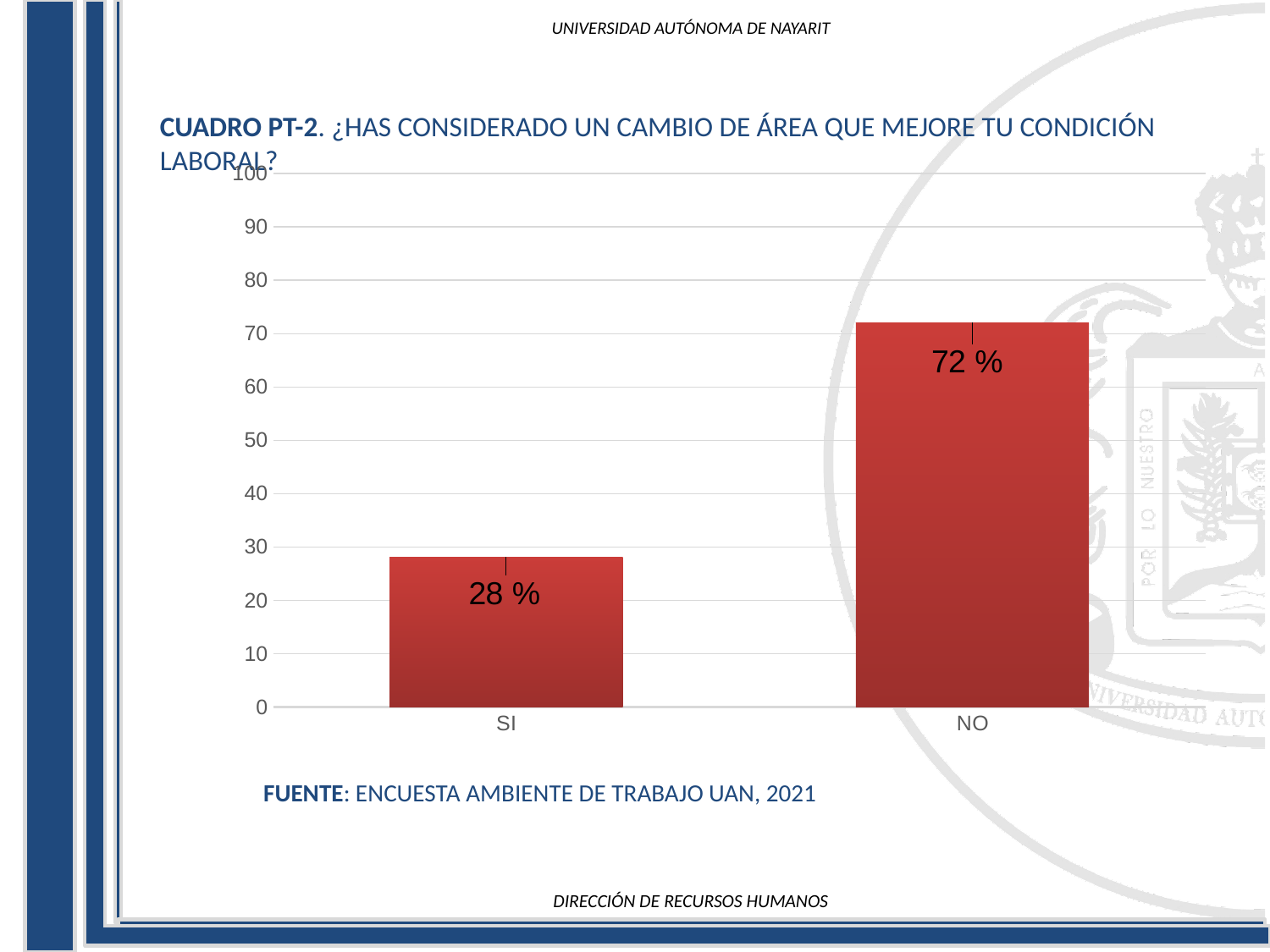
What kind of chart is shown on the slide? bar chart What is the difference between the values for NO and SI? 44 % Is the value for SI greater or less than 30? less What is the value for SI? 28 % Which category has the lowest value? SI Which category has the highest value? NO What is the value for NO? 72 % How many categories are shown on the x axis? 2 Is the value for NO greater or less than 70? greater What is the total of the two values shown in the chart? 100 % Which is larger, the value for SI or the value for NO? NO What is the source cited below the chart? ENCUESTA AMBIENTE DE TRABAJO UAN, 2021